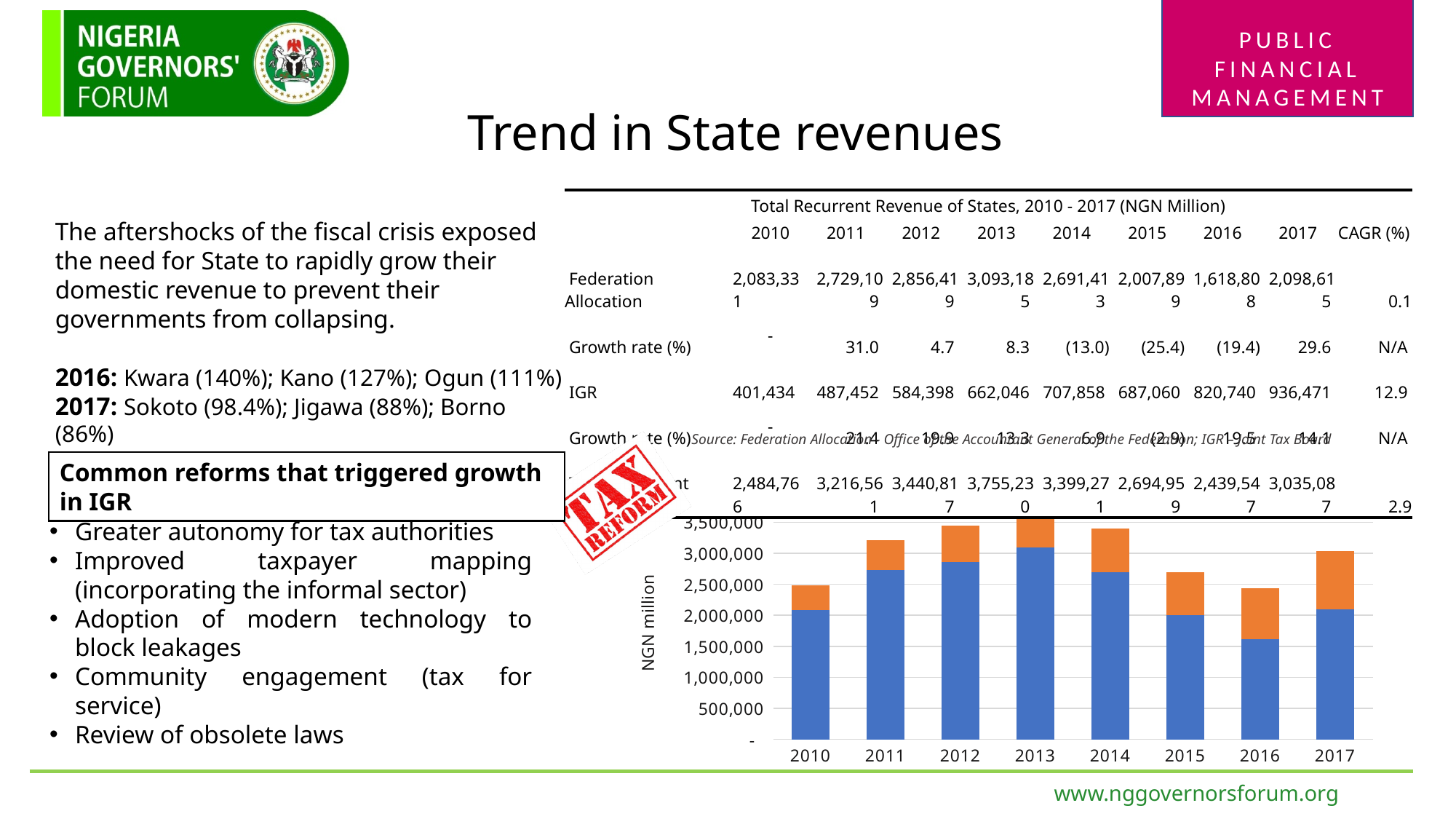
What is the label on the vertical axis of the bar chart? NGN million Do the total bar heights rise or fall from 2013 to 2016? fall Which year has the smallest blue segment in the bar chart? 2016 What kind of chart is shown at the bottom right of the slide? bar chart Which year has the largest blue segment in the bar chart? 2013 Is the total height of the 2015 bar greater or less than 3,000,000? less Which year has the tallest stacked bar in the chart? 2013 How many years are shown on the x axis of the bar chart? 8 Is the blue segment for 2012 greater or less than 2,500,000? greater Which stacked bar is taller, 2011 or 2015? 2011 Is the blue segment for 2016 greater or less than 2,000,000? less